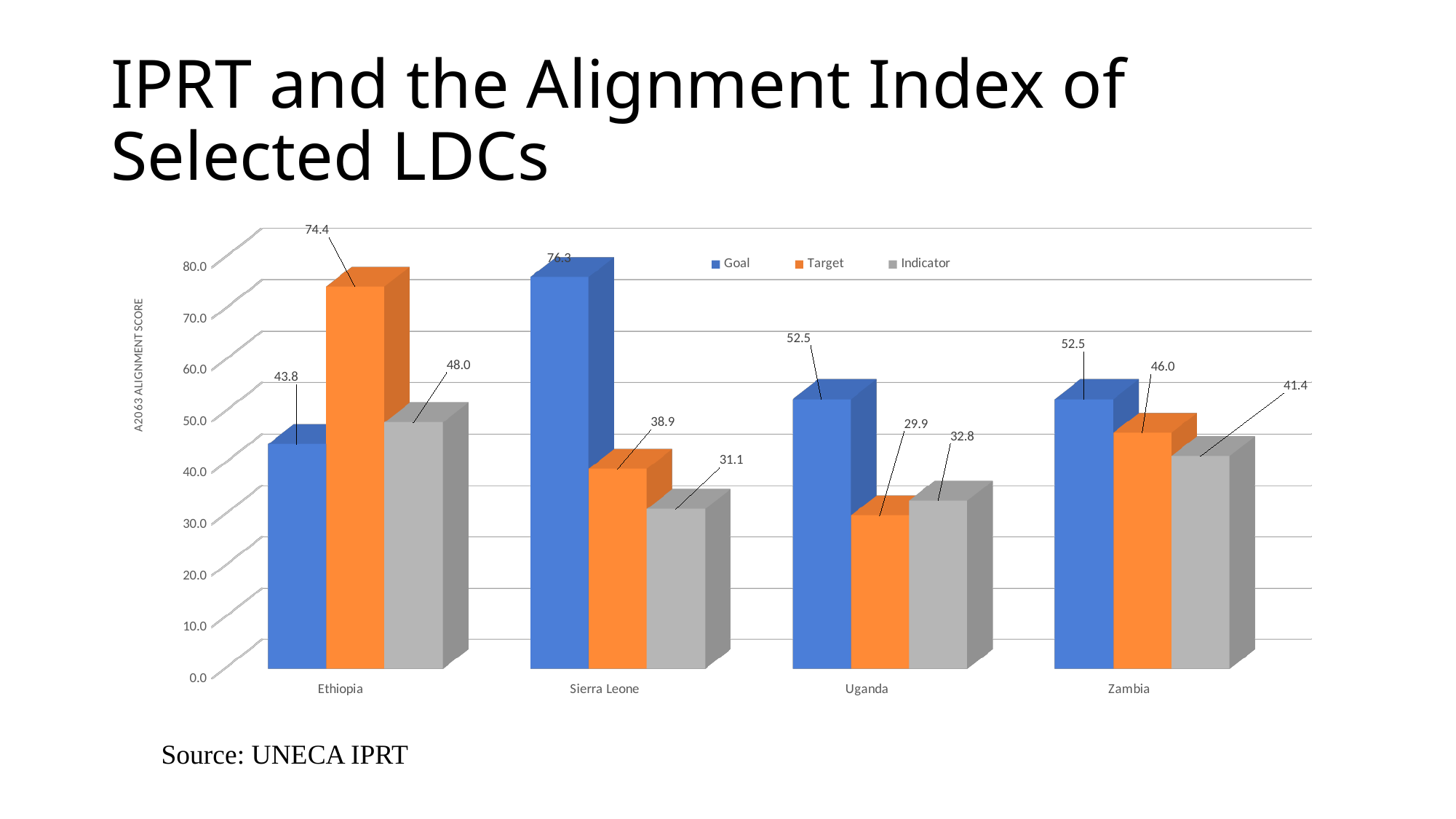
For Ethiopia, which is larger: the Goal value or the Target value? Target What is the Target value for Ethiopia? 74.4 What is the Target value for Zambia? 46.0 Which country has the highest Indicator value? Ethiopia How many countries are shown on the x axis? 4 Which country has the lowest Target value? Uganda What is the difference between the Goal and Target values for Sierra Leone? 37.4 What is the Goal value for Sierra Leone? 76.3 How many series does the legend list? 3 Which country has the highest Goal value? Sierra Leone What kind of chart is shown on the slide? Bar chart What is the Indicator value for Uganda? 32.8